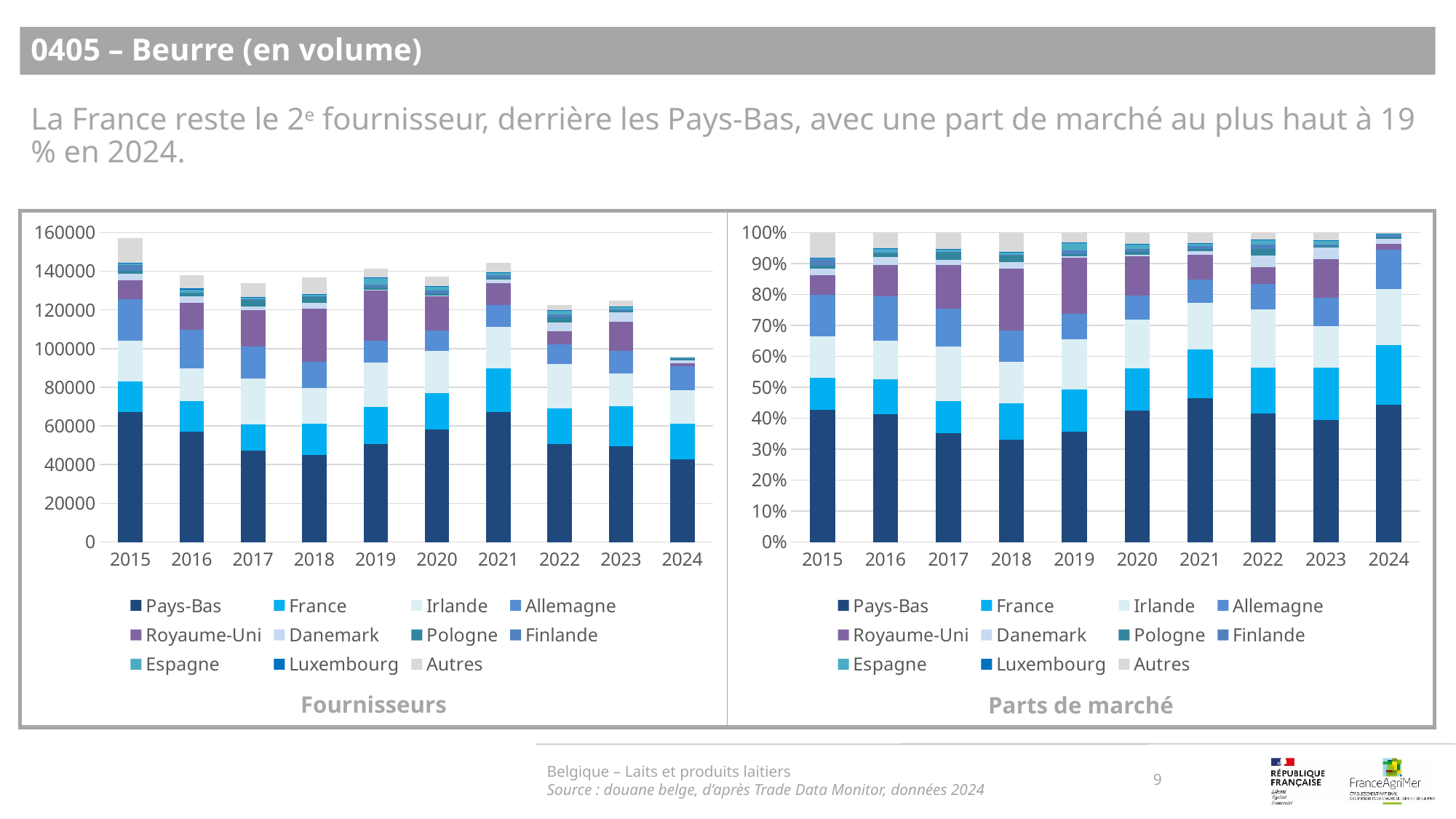
In the 'Parts de marché' chart, is the Pays-Bas share in 2024 greater or less than 40%? greater How many years are shown on the x axis of the 'Parts de marché' chart? 10 In the 'Parts de marché' chart, is the Pays-Bas share larger in 2021 or in 2018? 2021 What kind of chart is the 'Fournisseurs' chart? Stacked bar chart Which series is shown at the bottom of each stacked bar in the 'Fournisseurs' chart? Pays-Bas In the 'Parts de marché' chart, is the Pays-Bas share in 2018 greater or less than 40%? less In the 'Fournisseurs' chart, which year has the highest total bar? 2015 In the 'Fournisseurs' chart, is the total bar for 2015 greater or less than 140000? greater In the 'Fournisseurs' chart, is the total bar larger in 2021 or in 2022? 2021 In the 'Fournisseurs' chart, which year has the lowest total bar? 2024 How many series does the legend of the 'Fournisseurs' chart list? 11